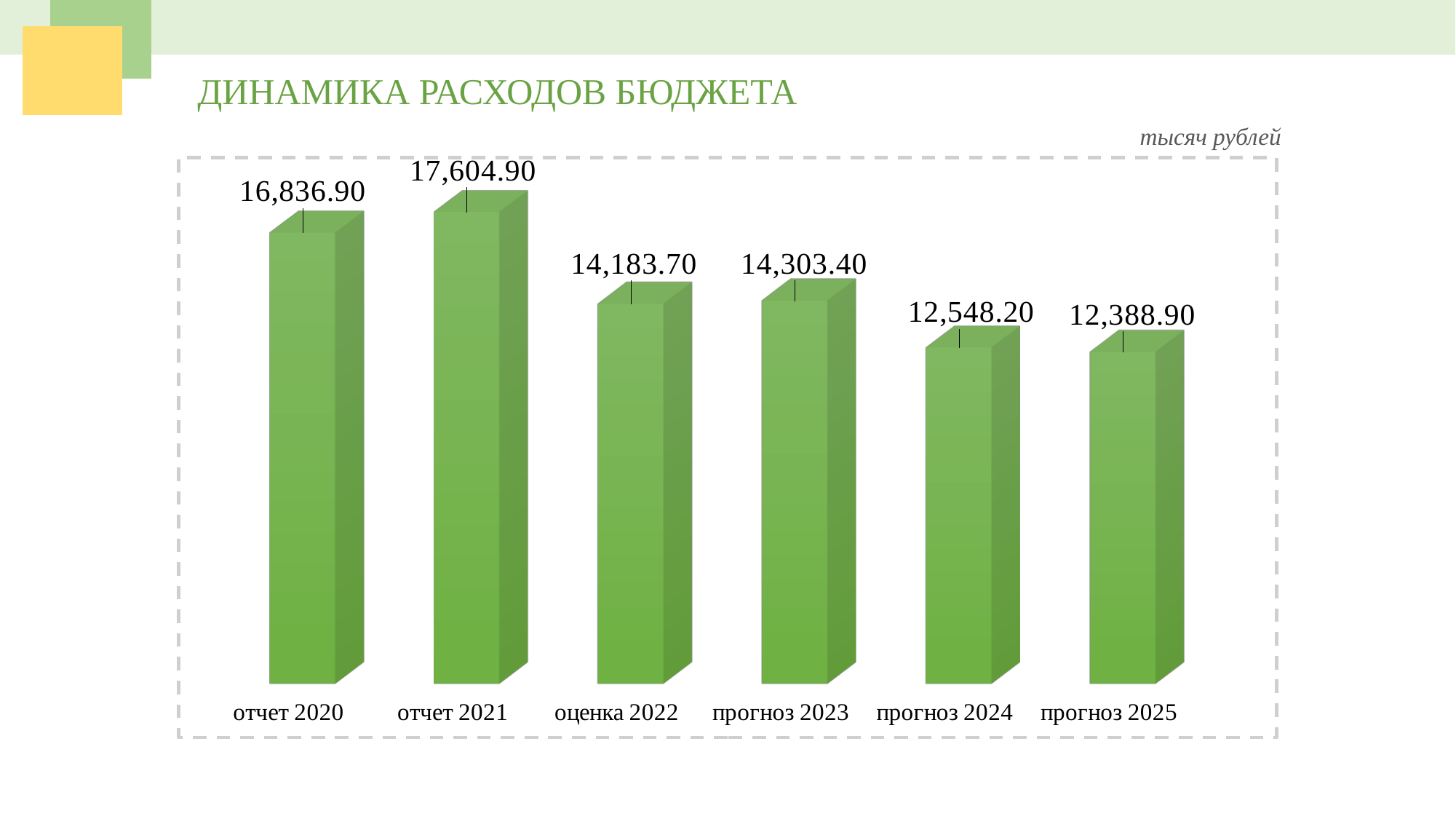
What is the value for оценка 2022? 14,183.70 Which is larger, the value for оценка 2022 or прогноз 2023? прогноз 2023 From отчет 2021 to прогноз 2025, do the values generally rise or fall? fall Which category has the lowest value? прогноз 2025 How many categories are shown on the chart? 6 What kind of chart is shown on the slide? bar chart What is the difference between the values for прогноз 2024 and прогноз 2025? 159.30 Which category has the highest value? отчет 2021 What is the value for прогноз 2024? 12,548.20 What is the difference between the values for отчет 2021 and отчет 2020? 768.00 What is the title of the chart? ДИНАМИКА РАСХОДОВ БЮДЖЕТА What is the value for отчет 2020? 16,836.90